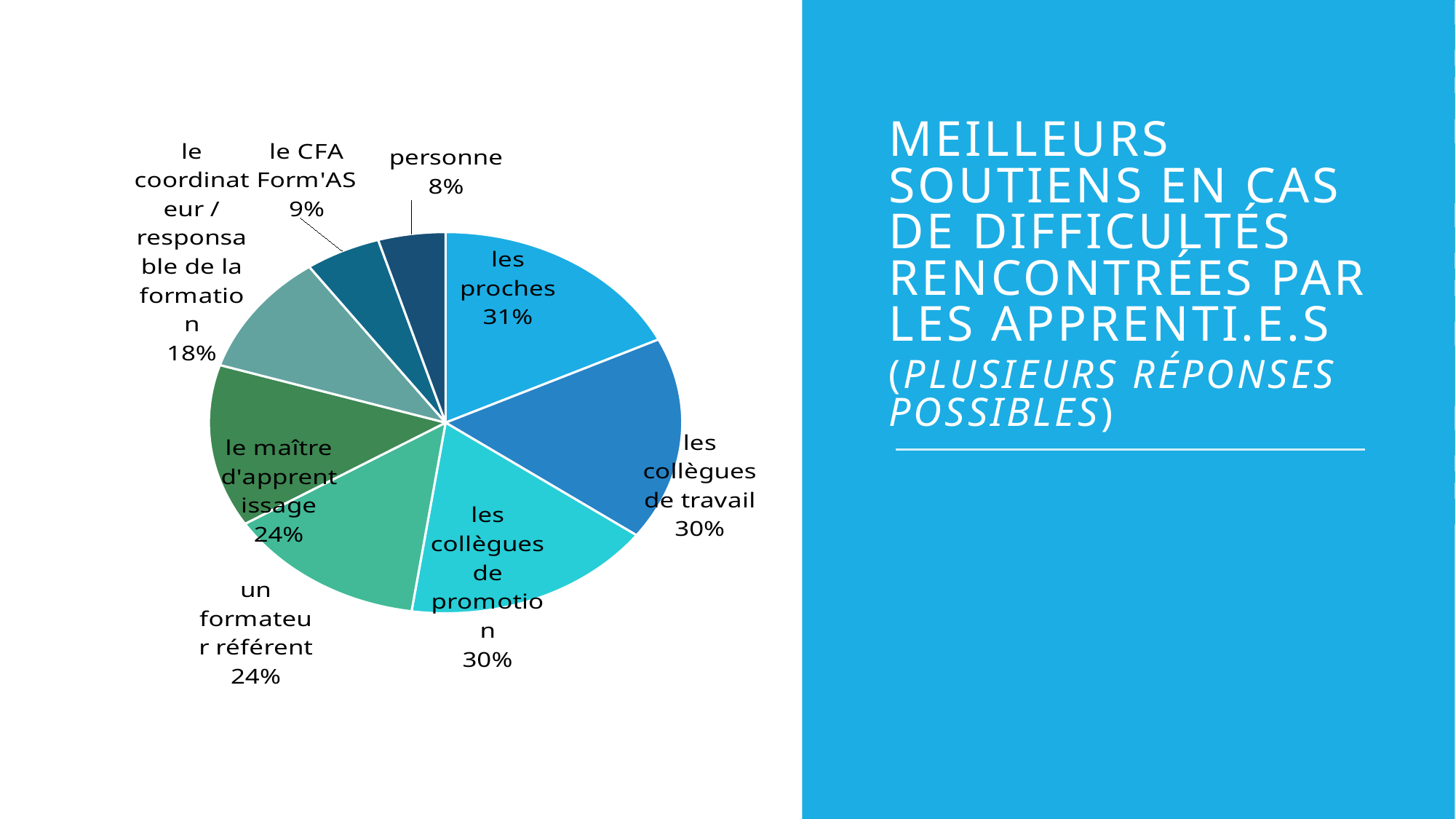
What is the difference in percentage points between "les proches" and "personne"? 23 What percentage is shown for "un formateur référent"? 24% What kind of chart is shown on the slide? Pie chart How many slices does the pie chart have? 8 What percentage is shown for "les proches"? 31% What percentage is shown for "le coordinateur / responsable de la formation"? 18% What percentage is shown for "le CFA Form'AS"? 9% Which category has the highest percentage in the pie chart? les proches What is the title of the slide? Meilleurs soutiens en cas de difficultés rencontrées par les apprenti.e.s (plusieurs réponses possibles) Which category has the lowest percentage in the pie chart? personne Which is larger: the percentage for "le maître d'apprentissage" or for "le coordinateur / responsable de la formation"? le maître d'apprentissage What percentage is shown for "les collègues de travail"? 30%